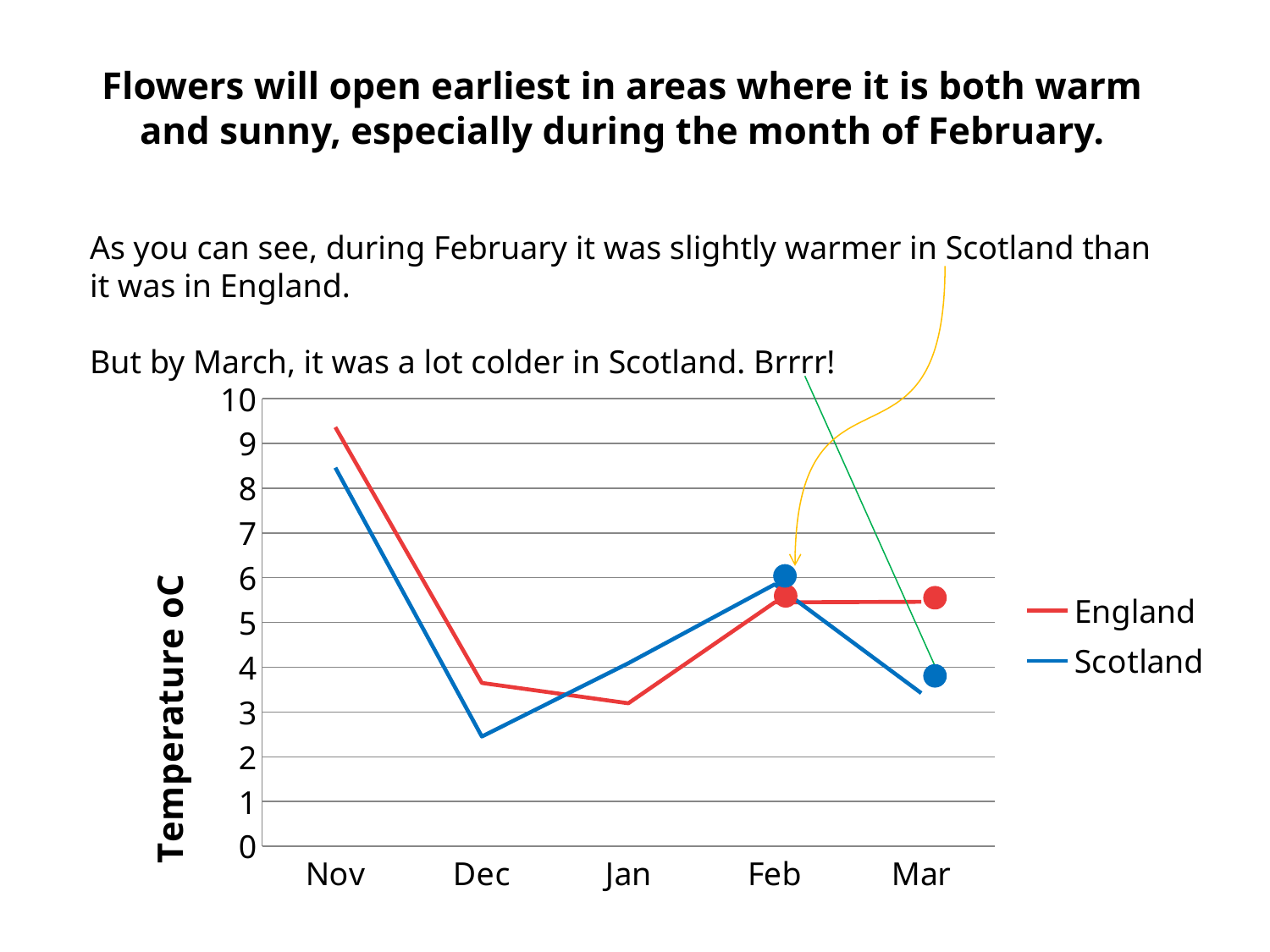
Is the Scotland temperature in Nov greater or less than 7? greater In which month is the Scotland temperature lowest? Dec In Mar, which is higher, the England or the Scotland temperature? England What kind of chart is shown on the slide? line chart Does the Scotland temperature rise or fall from Feb to Mar? fall In Nov, which is higher, the England or the Scotland temperature? England In which month is the England temperature highest? Nov Is the England temperature in Jan greater or less than 4? less In Dec, which is higher, the England or the Scotland temperature? England How many months are plotted along the x axis? 5 How many series does the legend list? 2